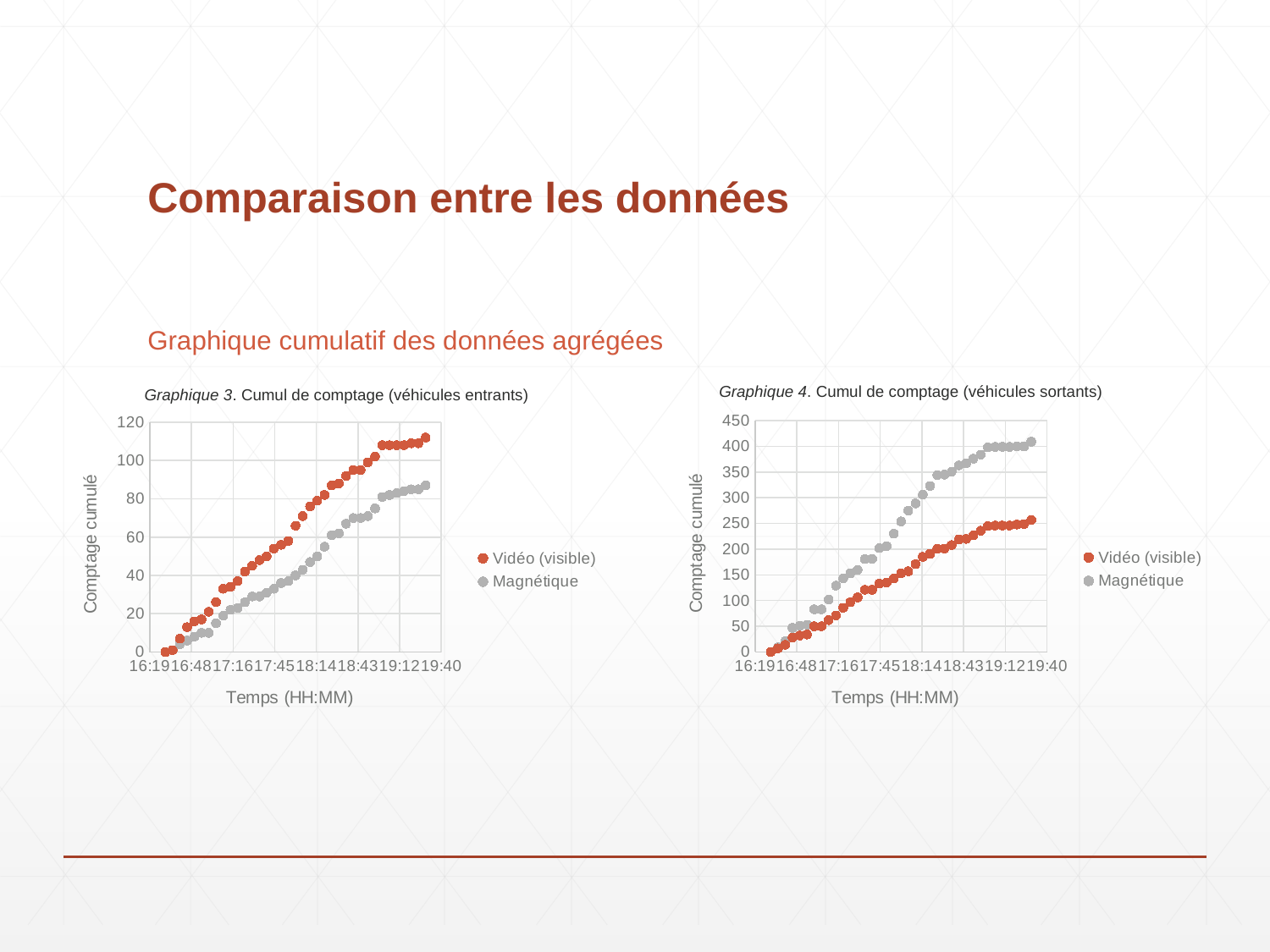
In Graphique 4 (véhicules sortants), which series reaches the higher value at the end of the period, Vidéo (visible) or Magnétique? Magnétique In Graphique 3 (véhicules entrants), is the final value for Magnétique greater or less than 100? less In Graphique 4 (véhicules sortants), do the values for Magnétique rise or fall over time? Rise What is the label of the y axis in Graphique 4 (véhicules sortants)? Comptage cumulé In Graphique 4 (véhicules sortants), is the final value for Vidéo (visible) greater or less than 300? less In Graphique 4 (véhicules sortants), is the final value for Magnétique greater or less than 350? greater How many series does the legend of Graphique 4 (véhicules sortants) list? 2 What is the label of the x axis in Graphique 3 (véhicules entrants)? Temps (HH:MM) In Graphique 3 (véhicules entrants), which series reaches the higher value at the end of the period, Vidéo (visible) or Magnétique? Vidéo (visible) In Graphique 3 (véhicules entrants), do the values for Vidéo (visible) rise or fall over time? Rise What kind of chart is Graphique 3 (véhicules entrants)? Scatter chart